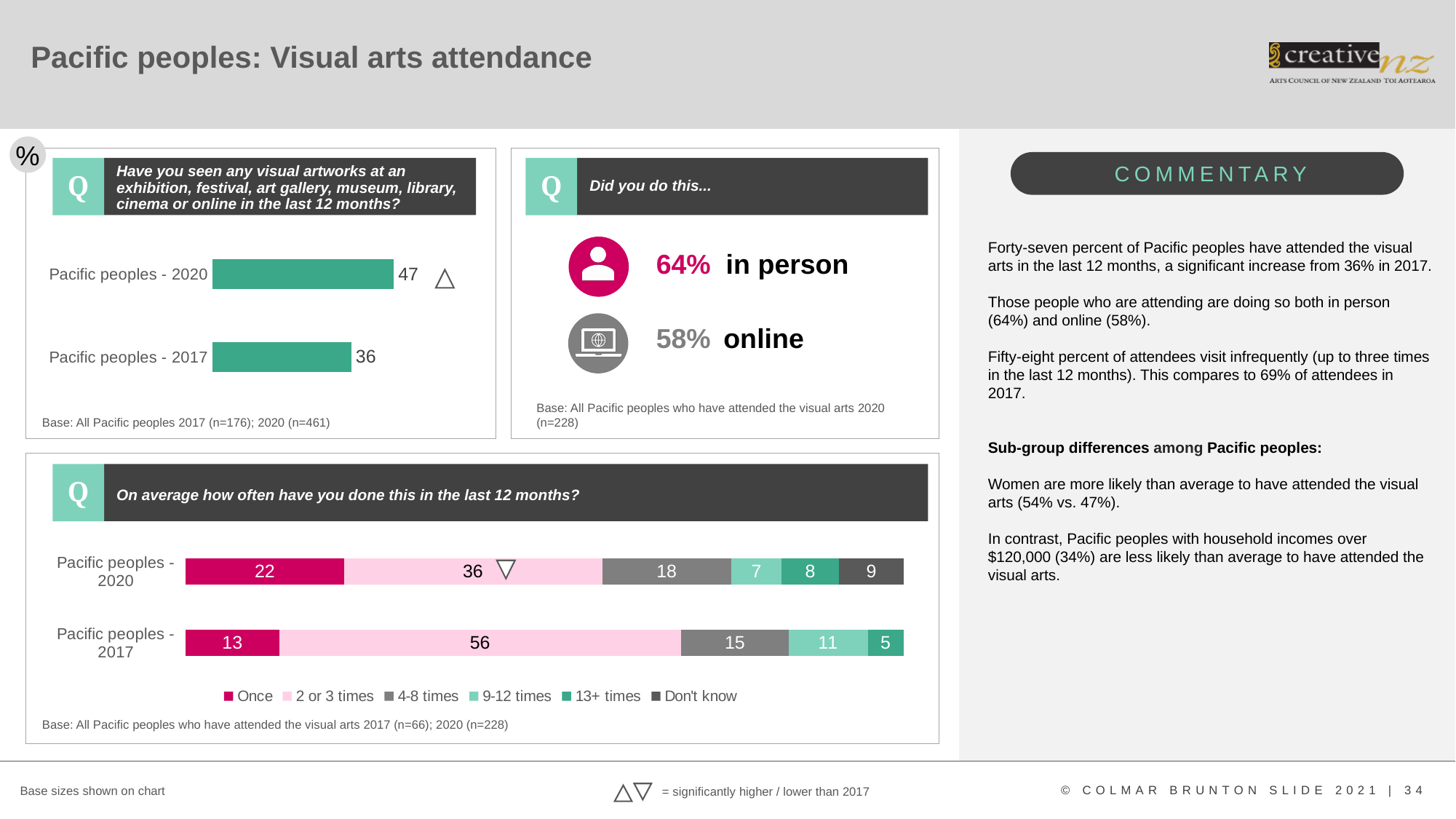
How many series does the legend list in the chart 'On average how often have you done this in the last 12 months?'? 6 In the chart 'Have you seen any visual artworks at an exhibition, festival, art gallery, museum, library, cinema or online in the last 12 months?', what is the difference between the 2020 and 2017 values? 11 In the chart 'On average how often have you done this in the last 12 months?', what is the value for '4-8 times' for Pacific peoples - 2020? 18 In the chart 'On average how often have you done this in the last 12 months?', what is the total of the Pacific peoples - 2020 stacked bar? 100 In the chart 'On average how often have you done this in the last 12 months?', what is the value for 'Once' for Pacific peoples - 2020? 22 In the chart 'On average how often have you done this in the last 12 months?', what is the difference between the '2 or 3 times' values for 2017 and 2020? 20 In the chart 'Have you seen any visual artworks at an exhibition, festival, art gallery, museum, library, cinema or online in the last 12 months?', which category has the higher value, Pacific peoples - 2020 or Pacific peoples - 2017? Pacific peoples - 2020 In the chart 'On average how often have you done this in the last 12 months?', what is the value for '2 or 3 times' for Pacific peoples - 2017? 56 In the chart 'On average how often have you done this in the last 12 months?', which segment is the largest in the Pacific peoples - 2017 bar? 2 or 3 times In the chart 'Have you seen any visual artworks at an exhibition, festival, art gallery, museum, library, cinema or online in the last 12 months?', what is the value for Pacific peoples - 2020? 47 In the chart 'Have you seen any visual artworks at an exhibition, festival, art gallery, museum, library, cinema or online in the last 12 months?', what is the value for Pacific peoples - 2017? 36 What kind of chart is the chart 'Have you seen any visual artworks at an exhibition, festival, art gallery, museum, library, cinema or online in the last 12 months?'? Bar chart